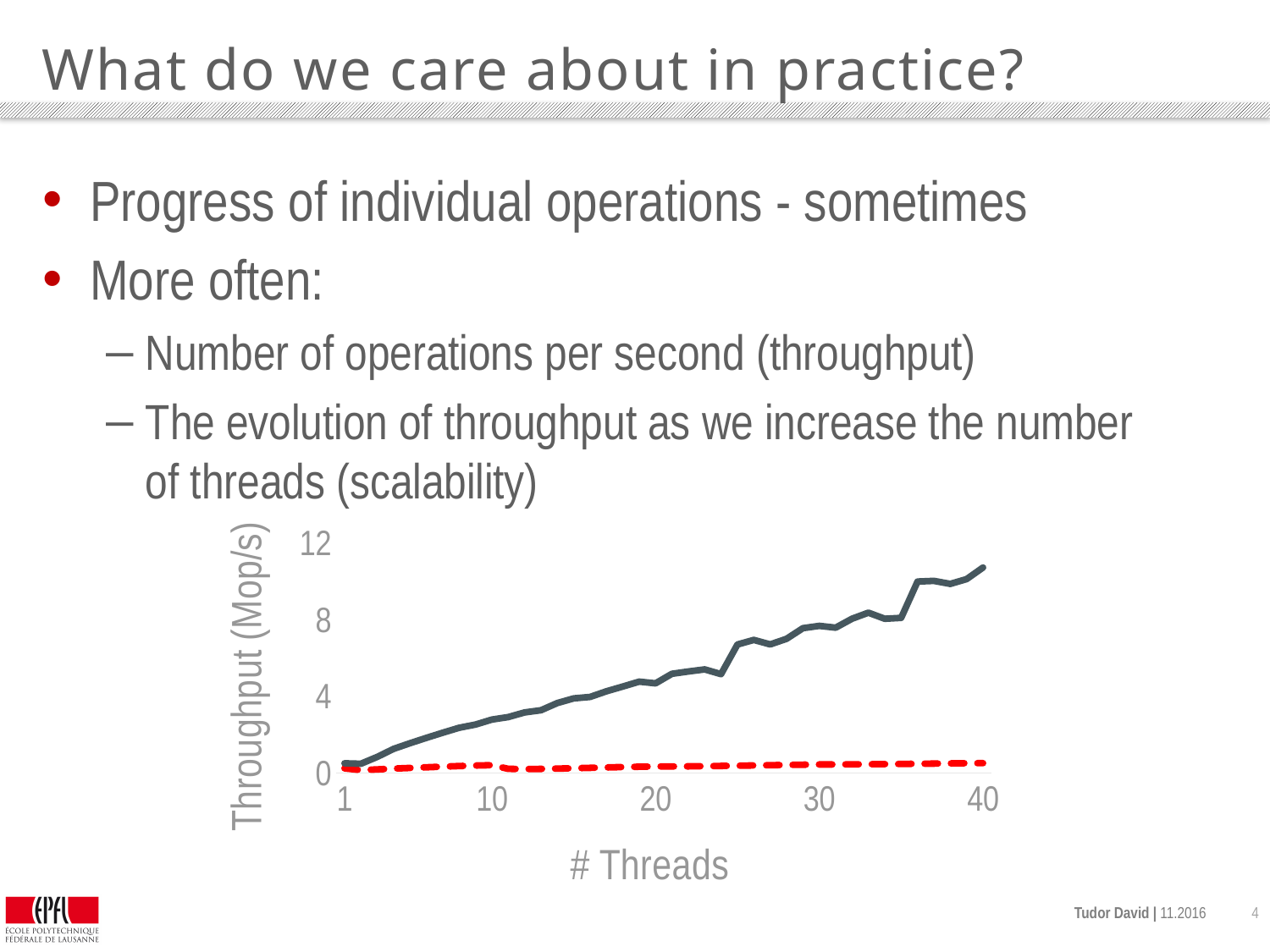
Is the value of the red dashed line at 40 threads greater or less than 4 Mop/s? less What is the highest tick value shown on the y axis of the chart? 12 What kind of chart is shown on the slide? line chart What is the label of the x axis of the chart? # Threads Is the value of the solid dark line at 40 threads greater or less than 8 Mop/s? greater Is the value of the solid dark line at 30 threads greater or less than 4 Mop/s? greater Does the solid dark line rise or fall as the number of threads increases from 1 to 40? rise How many lines are plotted on the chart? 2 What is the label of the y axis of the chart? Throughput (Mop/s) At 40 threads, which line has the higher throughput, the solid dark line or the red dashed line? the solid dark line